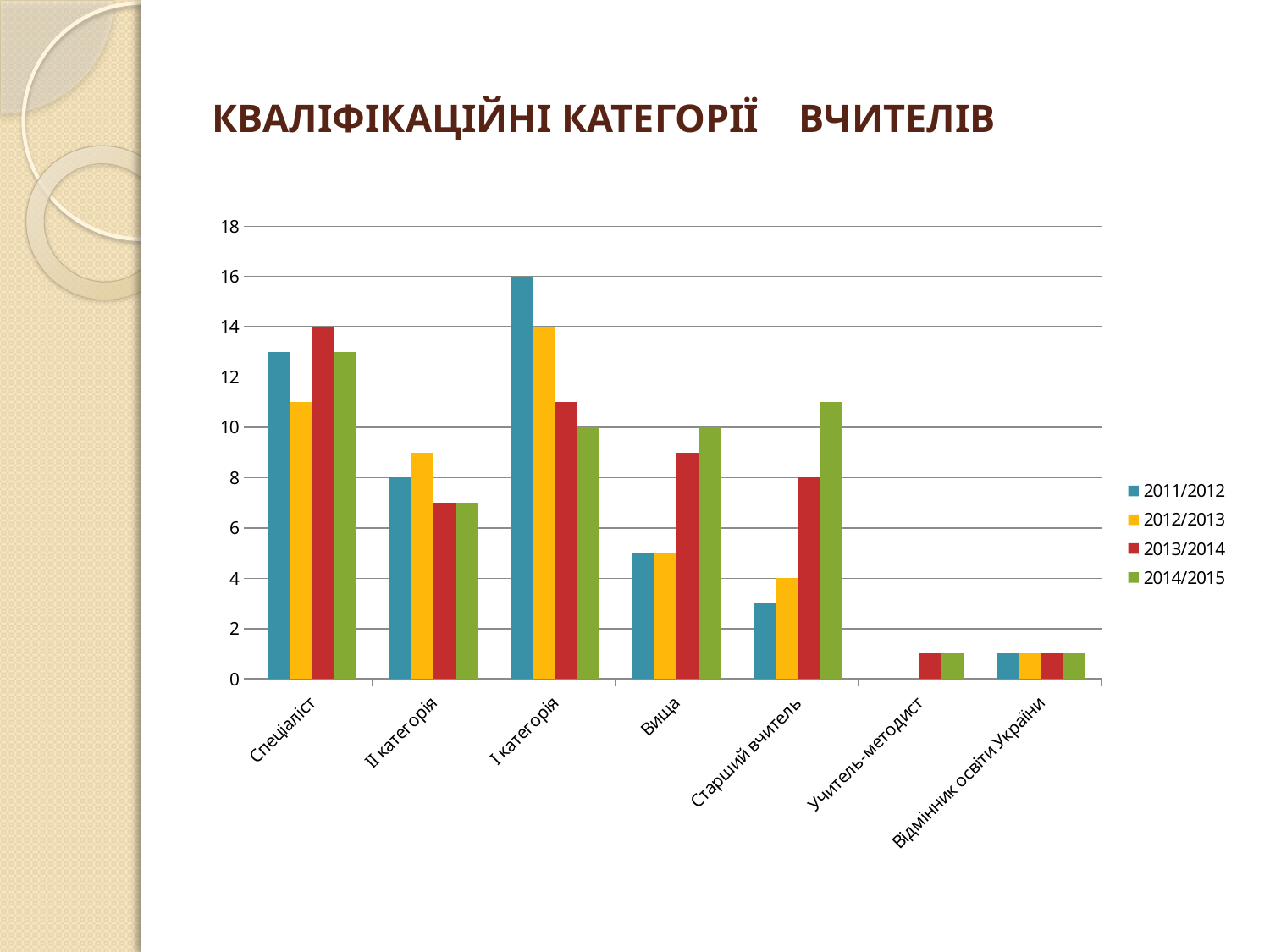
What is the value for 2011/2012 in the ІІ категорія category? 8 Which is larger in the Вища category: the 2011/2012 value or the 2014/2015 value? 2014/2015 How many categories are shown on the x axis? 7 What is the value for 2013/2014 in the Старший вчитель category? 8 What is the value for 2013/2014 in the Спеціаліст category? 14 Which category has the highest value for the 2011/2012 series? І категорія What kind of chart is shown on the slide? bar chart What is the value for 2011/2012 in the І категорія category? 16 Is the value for 2014/2015 in the Старший вчитель category greater or less than 10? greater Is the value for 2011/2012 in the Вища category greater or less than 6? less How many series does the legend list? 4 What is the difference between the 2011/2012 and 2014/2015 values in the І категорія category? 6